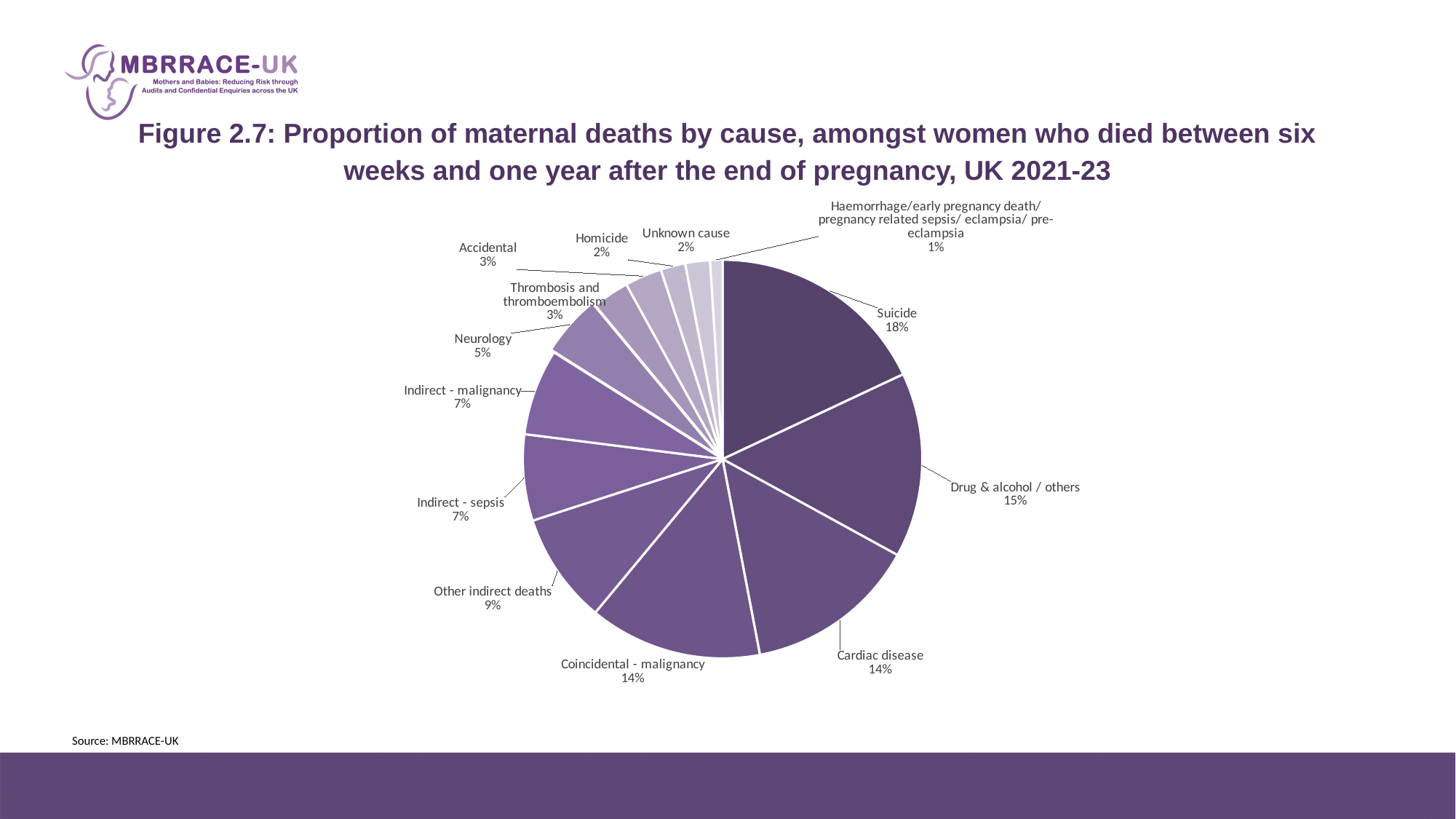
Which cause has the smallest share of the pie? Haemorrhage/early pregnancy death/ pregnancy related sepsis/ eclampsia/ pre-eclampsia What share of maternal deaths is attributed to Suicide? 18% How many slices does the pie chart have? 13 Which is larger, the share for Neurology or the share for Indirect - sepsis? Indirect - sepsis What percentage is shown for Other indirect deaths? 9% What percentage is shown for Cardiac disease? 14% What percentage is shown for Thrombosis and thromboembolism? 3% What is the difference in percentage points between Suicide and Drug & alcohol / others? 3 Which cause has the largest share of the pie? Suicide What type of chart is shown on the slide? Pie chart What is the figure number given in the chart title? Figure 2.7 What percentage is shown for Drug & alcohol / others? 15%